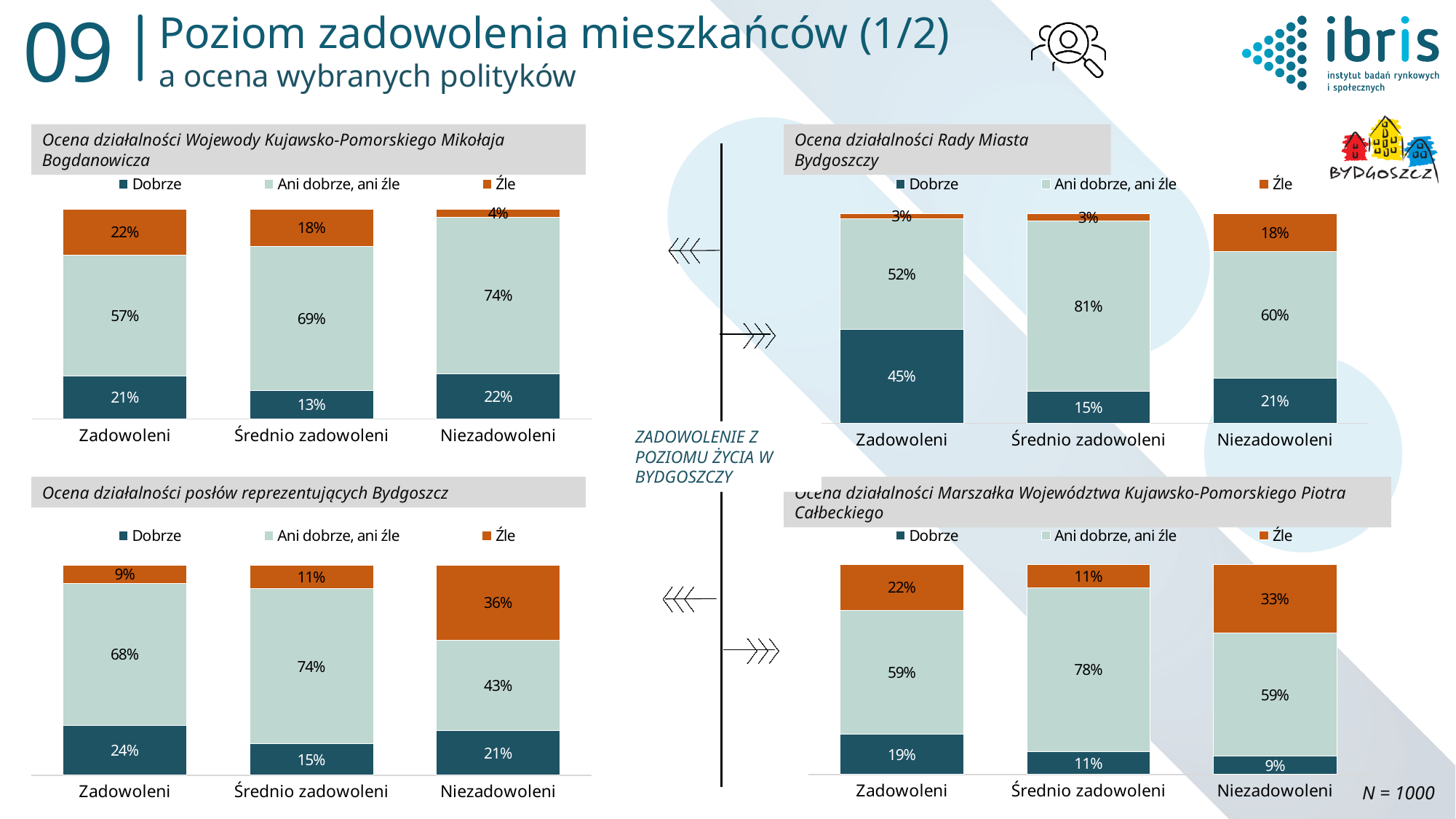
In the chart 'Ocena działalności Marszałka Województwa Kujawsko-Pomorskiego Piotra Całbeckiego', what is the 'Dobrze' value for Niezadowoleni? 9% In the chart 'Ocena działalności posłów reprezentujących Bydgoszcz', which is larger: the 'Dobrze' value for Zadowoleni or for Niezadowoleni? Zadowoleni In the chart 'Ocena działalności Wojewody Kujawsko-Pomorskiego Mikołaja Bogdanowicza', which category has the lowest 'Źle' value? Niezadowoleni In the chart 'Ocena działalności Marszałka Województwa Kujawsko-Pomorskiego Piotra Całbeckiego', what is the difference between the 'Źle' values for Niezadowoleni and Zadowoleni? 11% How many categories are shown on the x axis of the chart 'Ocena działalności Rady Miasta Bydgoszczy'? 3 In the chart 'Ocena działalności posłów reprezentujących Bydgoszcz', what is the 'Źle' value for Niezadowoleni? 36% What kind of chart is 'Ocena działalności Wojewody Kujawsko-Pomorskiego Mikołaja Bogdanowicza'? Stacked bar chart In the chart 'Ocena działalności Rady Miasta Bydgoszczy', what is the 'Dobrze' value for Zadowoleni? 45% In the chart 'Ocena działalności Wojewody Kujawsko-Pomorskiego Mikołaja Bogdanowicza', what is the 'Ani dobrze, ani źle' value for Średnio zadowoleni? 69% In the chart 'Ocena działalności Rady Miasta Bydgoszczy', which category has the highest 'Źle' value? Niezadowoleni How many series does the legend list in the chart 'Ocena działalności posłów reprezentujących Bydgoszcz'? 3 In the chart 'Ocena działalności Rady Miasta Bydgoszczy', what is the difference between the 'Ani dobrze, ani źle' values for Średnio zadowoleni and Niezadowoleni? 21%